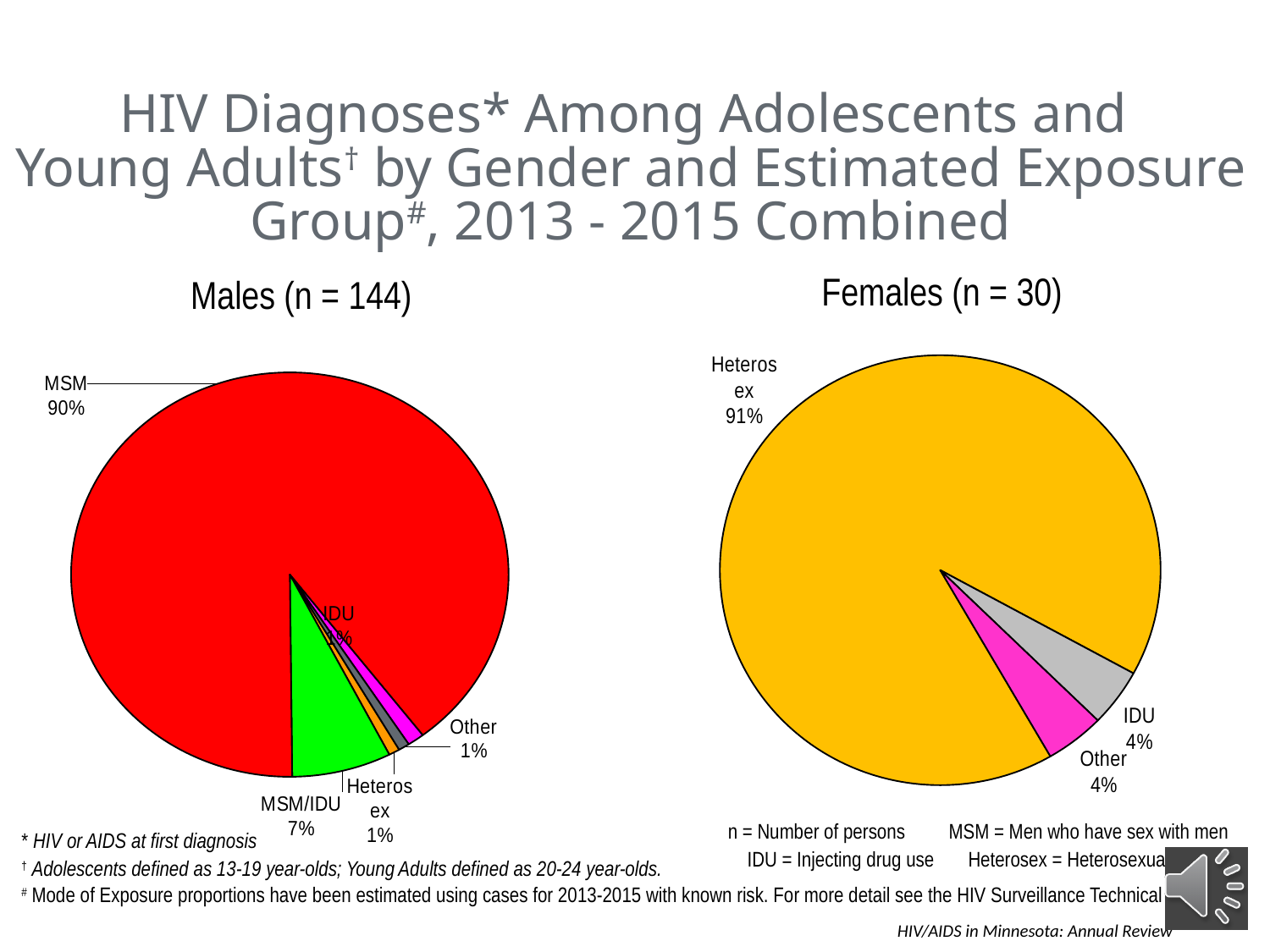
In the Males (n = 144) pie chart, what percentage is shown for Other? 1% In the Males (n = 144) pie chart, what is the difference in percentage points between MSM and MSM/IDU? 83 percentage points In the Females (n = 30) pie chart, which exposure group has the largest slice? Heterosex In the Males (n = 144) pie chart, which exposure group has the largest slice? MSM How many exposure group slices are shown in the Females (n = 30) pie chart? 3 In the Females (n = 30) pie chart, what share of diagnoses is attributed to Heterosex? 91% In the Males (n = 144) pie chart, what percentage is shown for MSM/IDU? 7% In the Females (n = 30) pie chart, what percentage is shown for IDU? 4% In the Males (n = 144) pie chart, what percentage is shown for Heterosex? 1% In the Males (n = 144) pie chart, what share of diagnoses is attributed to MSM? 90% What type of chart is used for the Males and Females exposure group data? Pie chart In the Females (n = 30) pie chart, what percentage is shown for Other? 4%